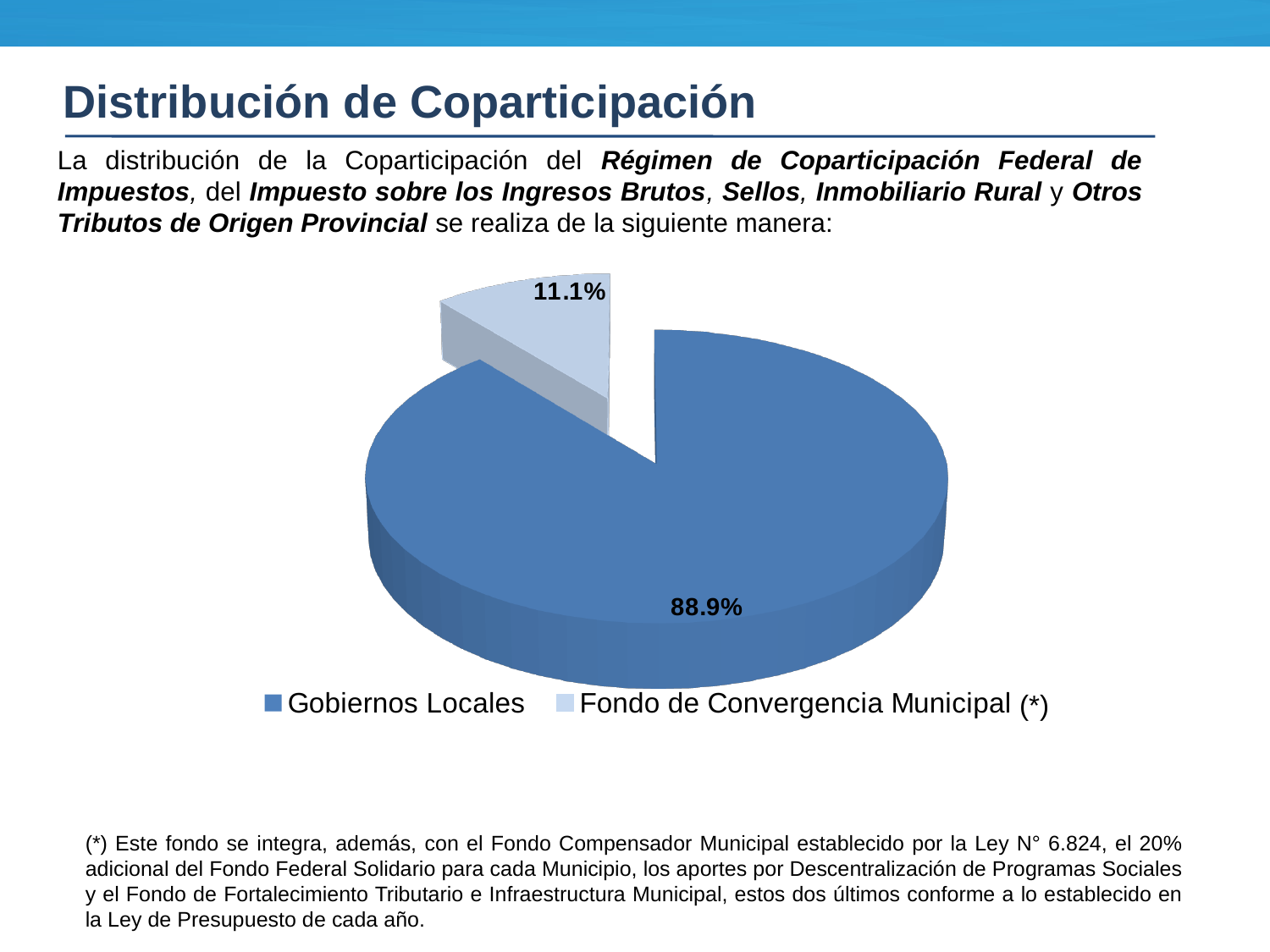
What kind of chart is shown on the slide? Pie chart What share of the pie does Fondo de Convergencia Municipal (*) receive? 11.1% Which legend entry is shown in the lighter blue colour? Fondo de Convergencia Municipal (*) What share of the pie does Gobiernos Locales receive? 88.9% How many slices does the pie chart have? 2 Which category has the smallest slice of the pie? Fondo de Convergencia Municipal (*) How many entries does the legend list? 2 What is the difference in percentage points between the Gobiernos Locales share and the Fondo de Convergencia Municipal (*) share? 77.8 Which category has the largest slice of the pie? Gobiernos Locales Which is larger, the share for Gobiernos Locales or the share for Fondo de Convergencia Municipal (*)? Gobiernos Locales What is the title of the slide containing the pie chart? Distribución de Coparticipación What is the combined share of the two slices in the pie chart? 100%